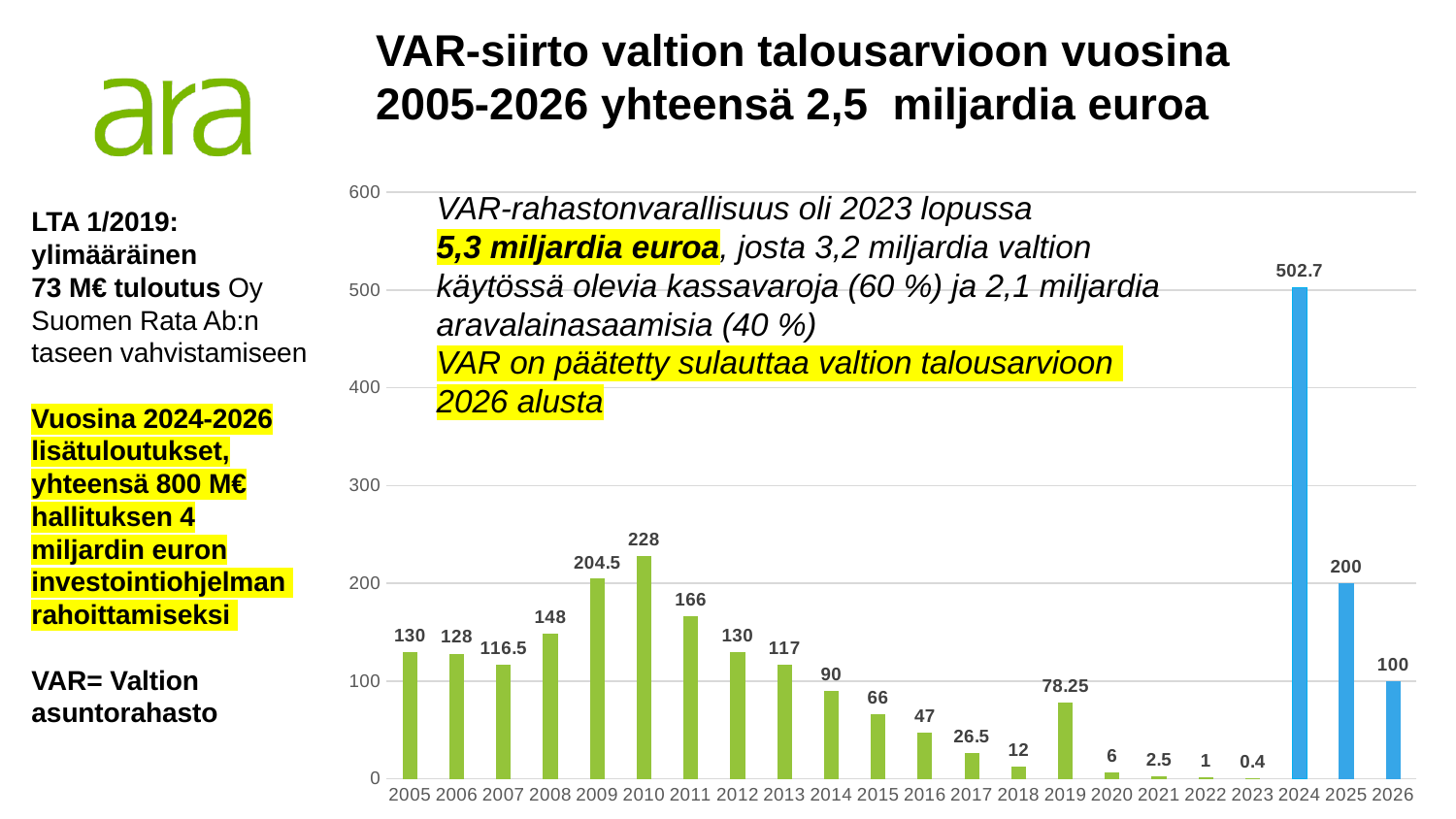
Is the value for 2025 greater or less than 300? less What is the value for 2009? 204.5 What is the value for 2024? 502.7 What kind of chart is shown on the slide? bar chart Which is larger, the value for 2011 or the value for 2008? 2011 What is the difference between the values for 2024 and 2025? 302.7 Which year has the highest value? 2024 Do the values rise or fall from 2010 to 2018? fall Which year has the lowest value? 2023 What is the difference between the values for 2010 and 2009? 23.5 How many years are shown on the x axis? 22 What is the value for 2019? 78.25